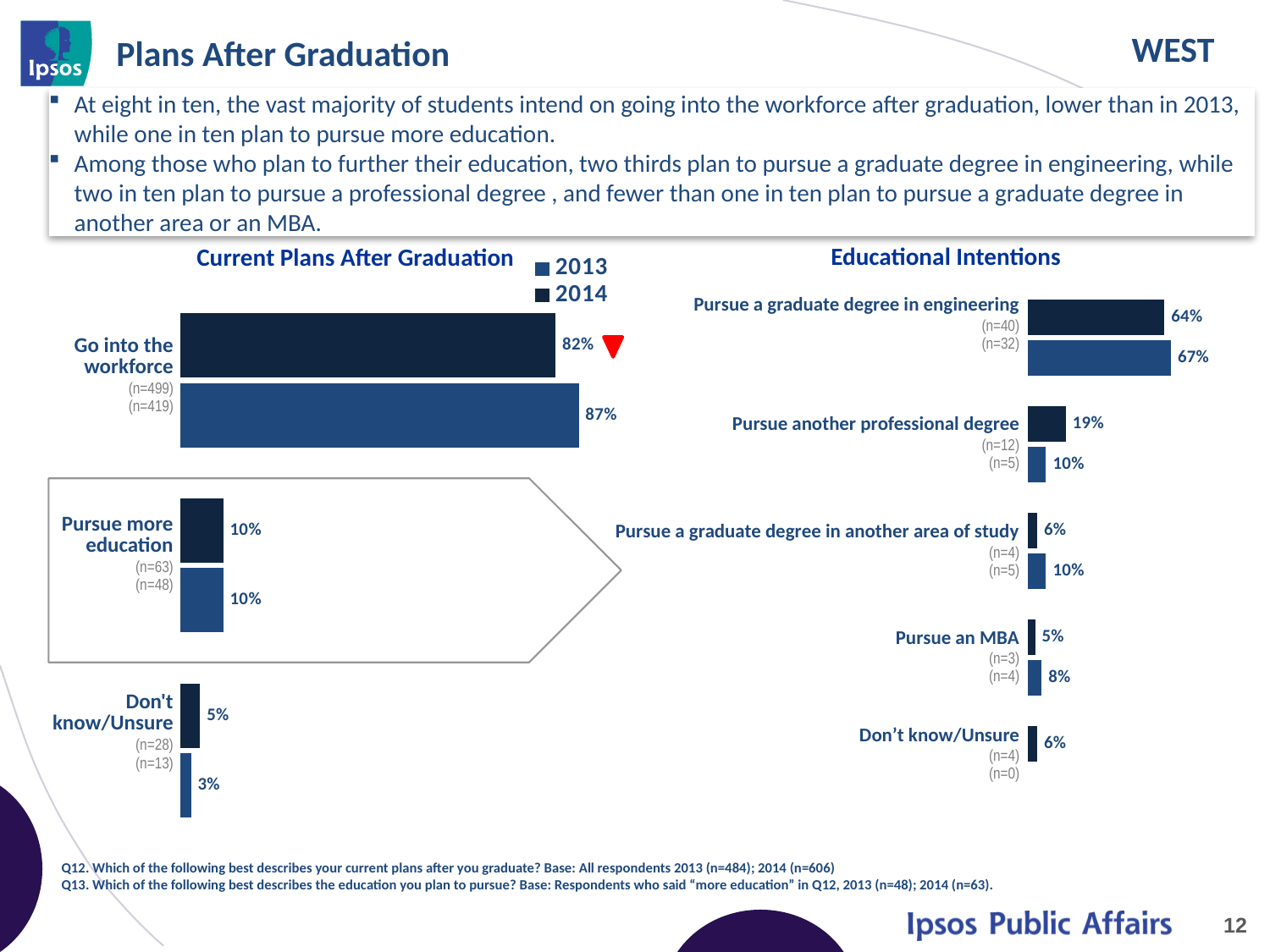
How many categories are shown in the 'Educational Intentions' chart? 5 What kind of chart is the 'Current Plans After Graduation' chart? Bar chart In the 'Current Plans After Graduation' chart, which category has the lowest values? Don't know/Unsure In the 'Current Plans After Graduation' chart, what value is shown on both bars for 'Pursue more education'? 10% In the 'Educational Intentions' chart, what value is shown on the dark navy bar for 'Pursue another professional degree'? 19% In the 'Educational Intentions' chart, which category has the highest values? Pursue a graduate degree in engineering In the 'Educational Intentions' chart, which bar for 'Pursue an MBA' is larger, the dark navy bar or the lighter blue bar? The lighter blue bar In the 'Current Plans After Graduation' chart, what is the difference between the two bars for 'Go into the workforce' (87% and 82%)? 5 percentage points In the 'Current Plans After Graduation' chart, what value is shown on the lighter blue bar for 'Don't know/Unsure'? 3% What is the title of the chart on the right side of the slide? Educational Intentions How many series does the legend on the slide list? 2 How many categories are shown in the 'Current Plans After Graduation' chart? 3